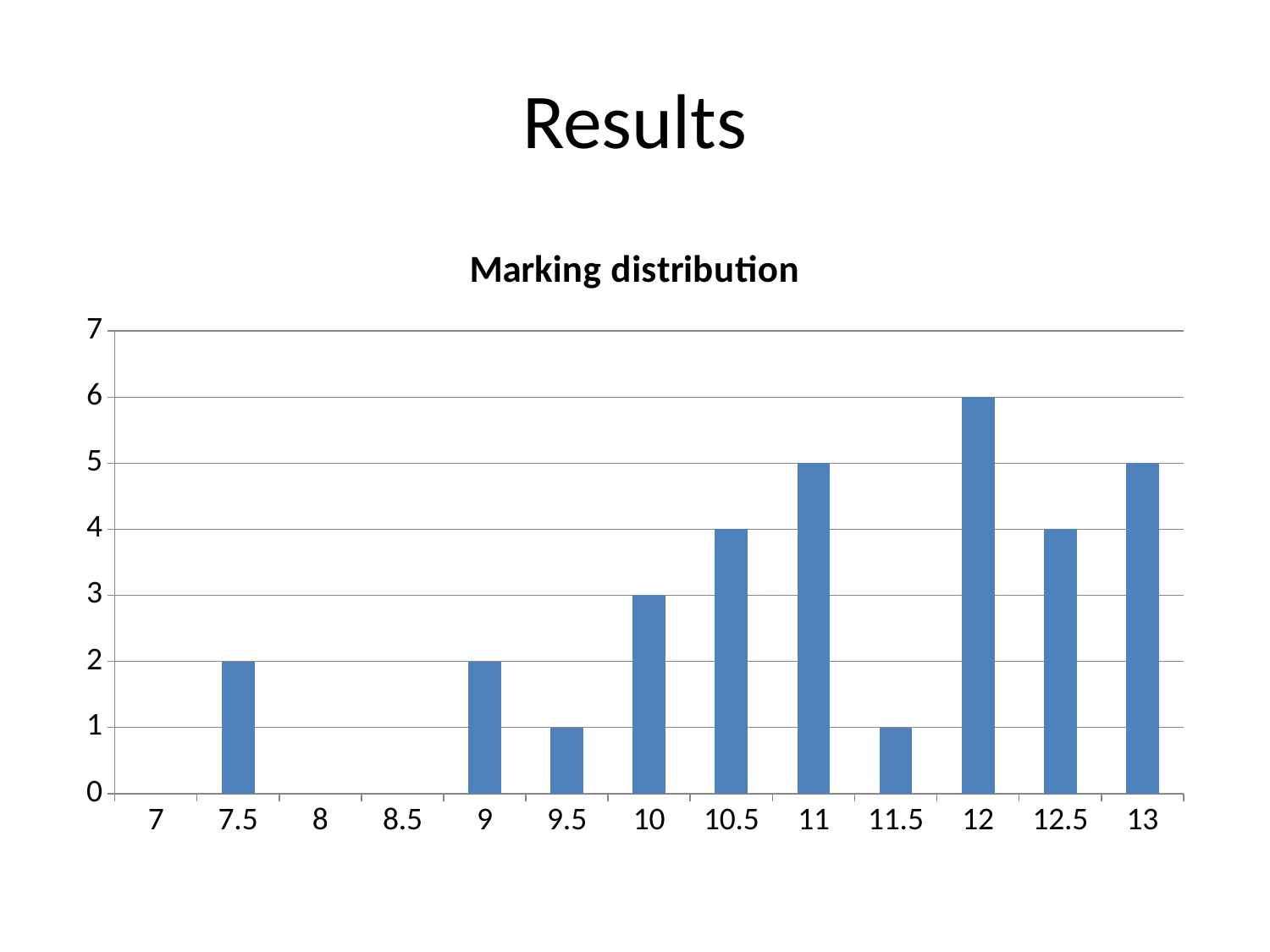
What is the difference between the values for 13 and 10? 2 Which is larger, the value for 11 or the value for 11.5? 11 How many categories are shown on the x axis? 13 What is the difference between the values for 12 and 12.5? 2 What is the value for category 10? 3 What type of chart is shown on the slide? bar chart What is the value for category 7.5? 2 What is the value for category 9.5? 1 Which category has the highest value? 12 What is the title of the chart? Marking distribution Which is larger, the value for 10.5 or the value for 9? 10.5 What is the value for category 12? 6